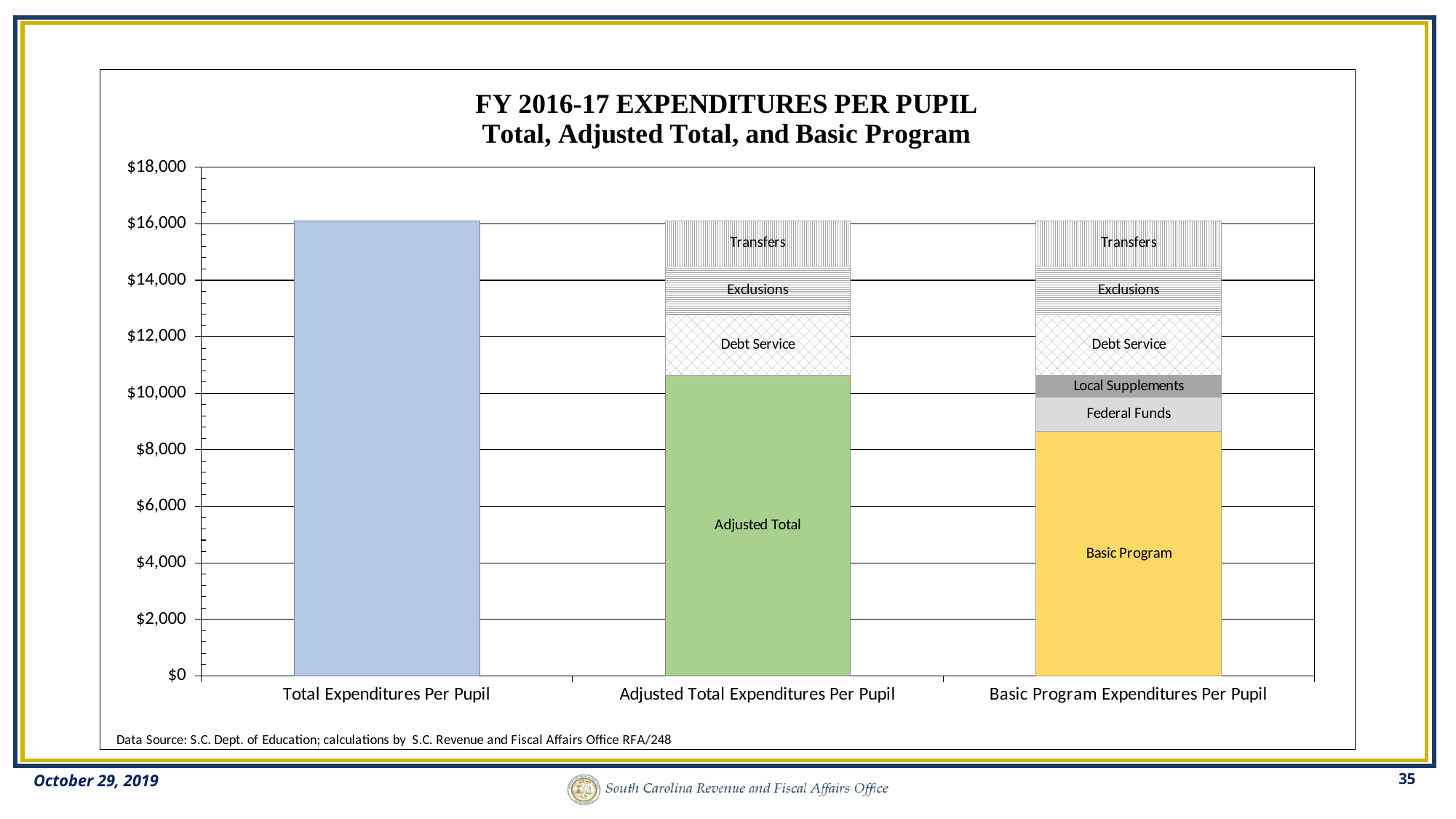
How many categories are shown on the x axis of the chart? 3 Is the Adjusted Total segment in the Adjusted Total Expenditures Per Pupil bar greater or less than $12,000? less Is the value for Total Expenditures Per Pupil greater or less than $14,000? greater Which is larger: the Adjusted Total segment or the Basic Program segment? Adjusted Total Is the Basic Program segment in the Basic Program Expenditures Per Pupil bar greater or less than $8,000? greater In the Basic Program Expenditures Per Pupil bar, which segment is larger: Debt Service or Local Supplements? Debt Service What is the title of the chart? FY 2016-17 EXPENDITURES PER PUPIL Total, Adjusted Total, and Basic Program How many labelled segments make up the Basic Program Expenditures Per Pupil bar? 6 What kind of chart is shown on the slide? bar chart